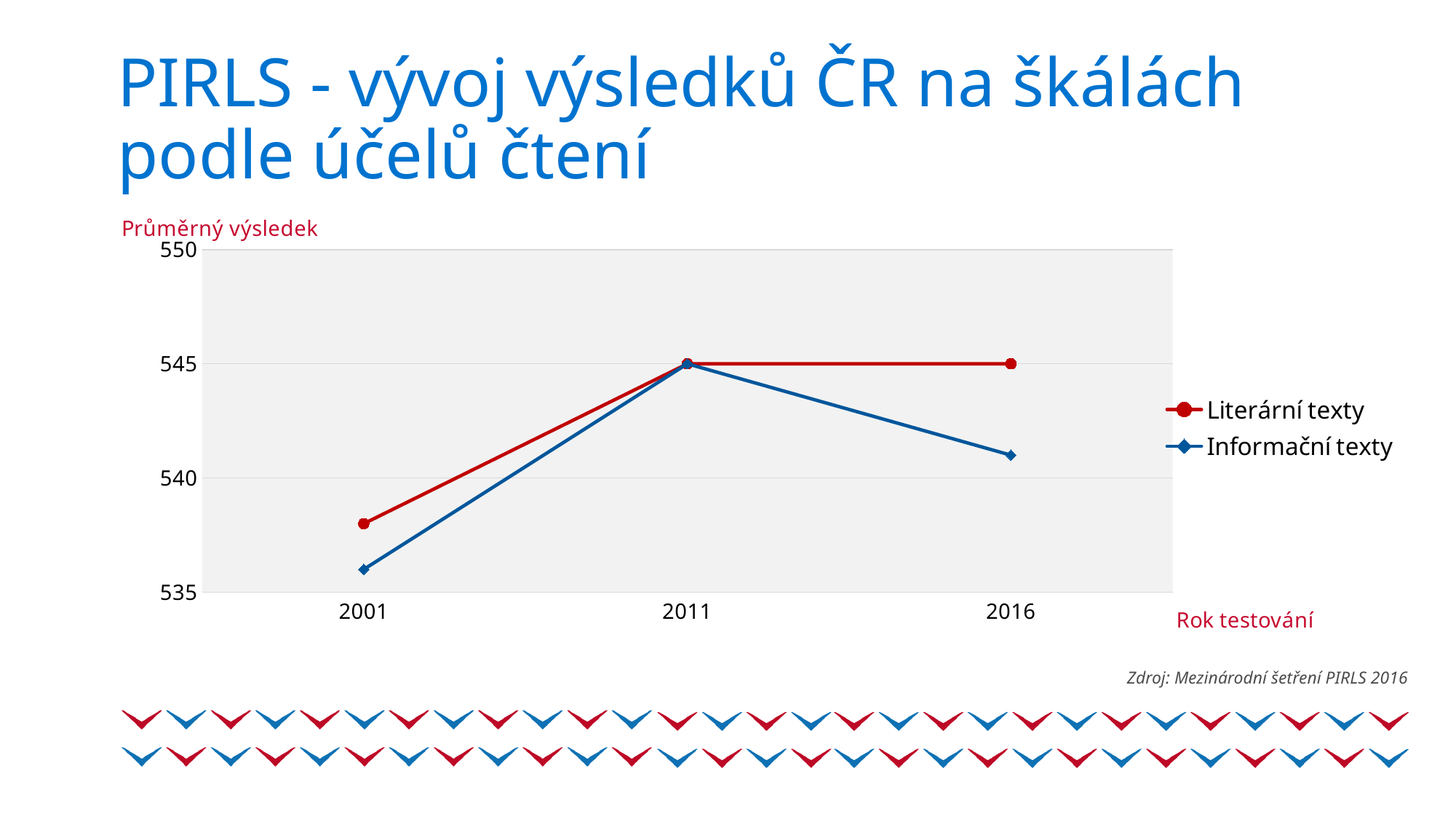
Is the value for Literární texty in 2001 greater or less than 540? less What is the value for Literární texty in 2016? 545 In which year is the value for Informační texty highest? 2011 Which series has the higher value in 2001, Literární texty or Informační texty? Literární texty How many series does the legend list? 2 What kind of chart is shown on the slide? line chart Is the value for Informační texty in 2016 greater or less than 540? greater What is the value for Informační texty in 2011? 545 How many testing years are plotted on the x axis? 3 Does the value for Informační texty rise or fall from 2011 to 2016? fall Which series has the higher value in 2016, Literární texty or Informační texty? Literární texty What is the label of the x axis? Rok testování